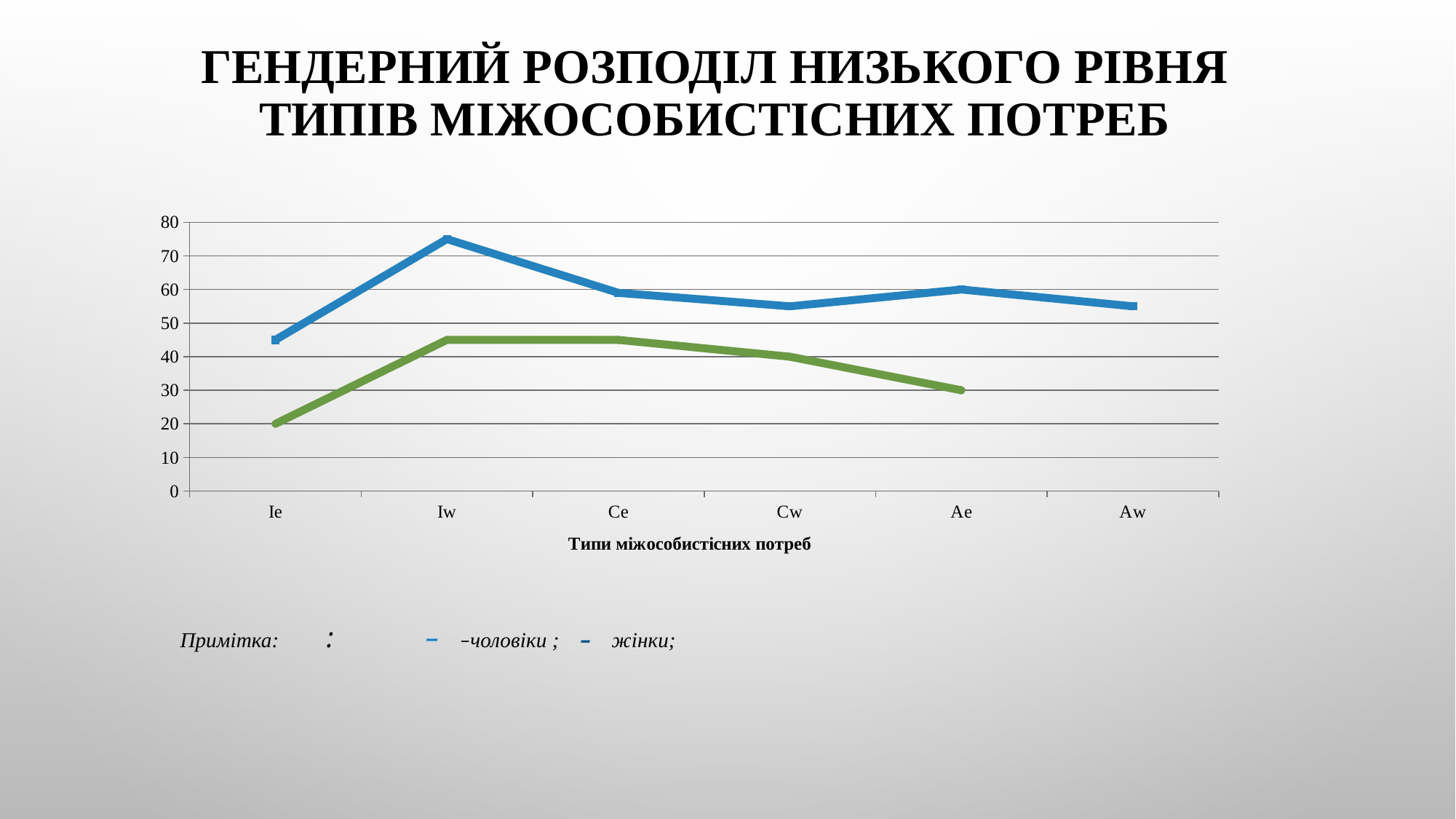
At which category does the blue line have its lowest value? Ie Is the value of the blue line at Ie greater or less than 50? less How many categories are shown on the x axis of the chart? 6 At which category does the green line have its lowest value? Ie Is the value of the blue line at Iw greater or less than 70? greater What is the title of the x axis of the chart? Типи міжособистісних потреб What kind of chart is shown on the slide? line chart Is the value of the green line at Ie greater or less than 30? less At category Ce, which line has the higher value, the blue line or the green line? blue line How many lines (series) are plotted on the chart? 2 At which category does the blue line reach its highest value? Iw Does the green line rise or fall from Ce to Ae? fall